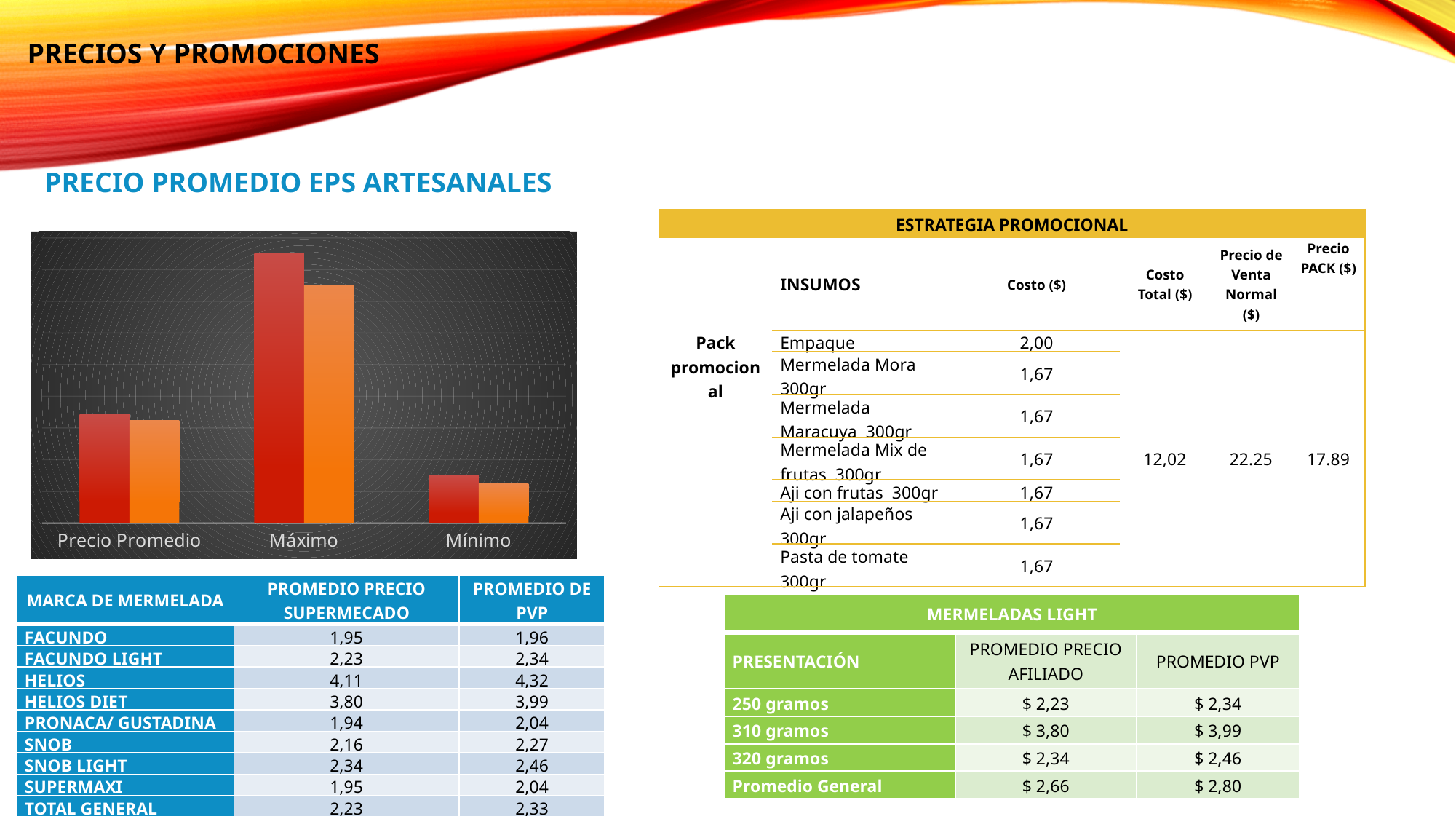
Which category in the bar chart has the tallest bars? Máximo In the bar chart, do the values rise or fall from Precio Promedio to Máximo? rise What kind of chart is shown on the left of the slide? bar chart In the Máximo category of the bar chart, which bar is taller, the red one or the orange one? the red one How many categories are shown on the x axis of the bar chart? 3 How many series (bars per category) does the bar chart plot? 2 In the bar chart, which category has the larger values, Precio Promedio or Mínimo? Precio Promedio Which category in the bar chart has the shortest bars? Mínimo In the bar chart, which category has the larger values, Precio Promedio or Máximo? Máximo What two colours are used for the bars in the bar chart? red and orange What is the heading printed above the bar chart? PRECIO PROMEDIO EPS ARTESANALES In the bar chart, do the values rise or fall from Máximo to Mínimo? fall